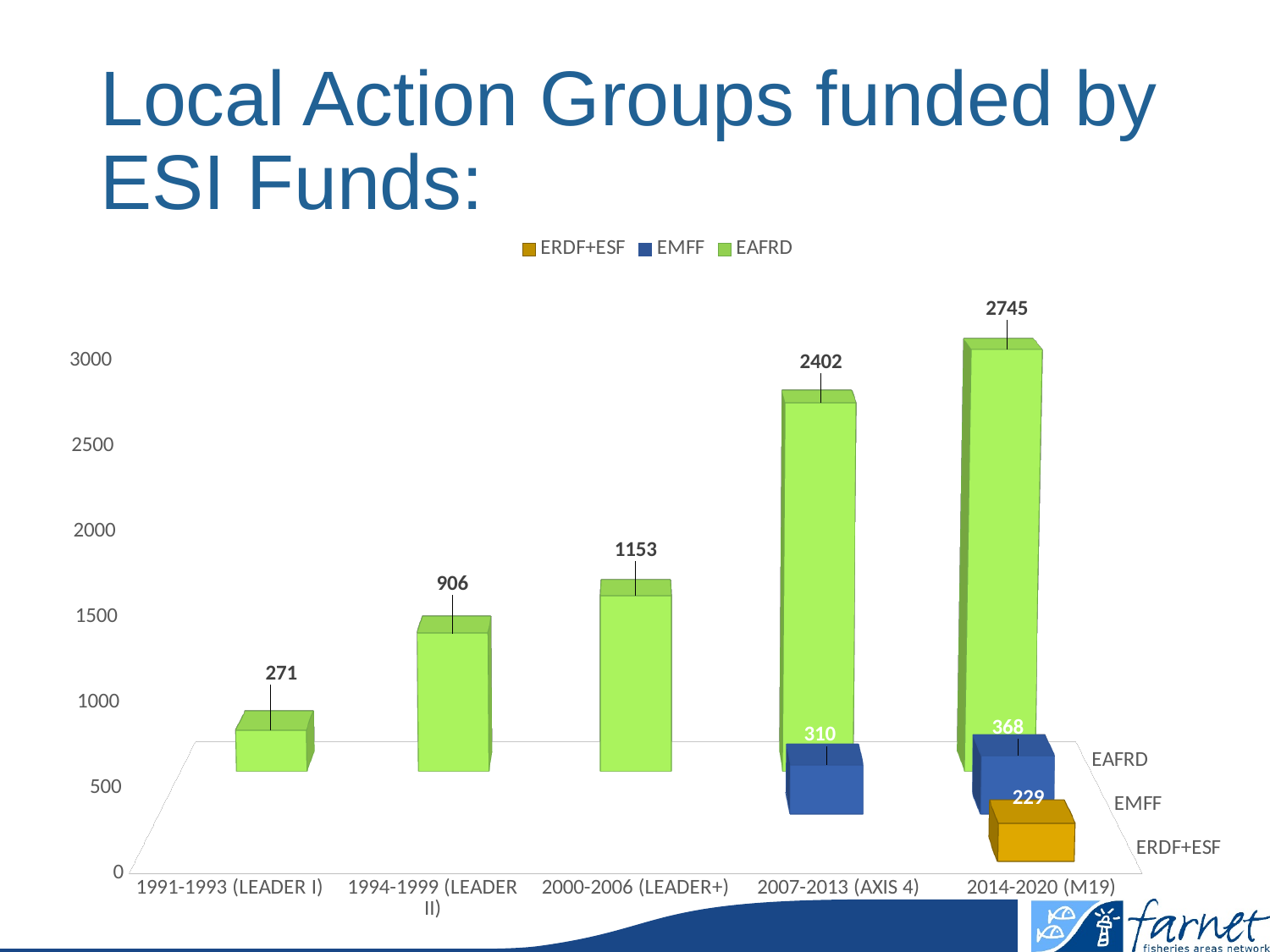
Which period has the lowest EAFRD value? 1991-1993 (LEADER I) What is the difference between the EAFRD values for 2014-2020 (M19) and 2007-2013 (AXIS 4)? 343 How many periods are shown on the x axis? 5 What is the EAFRD value for 1994-1999 (LEADER II)? 906 What is the EMFF value for 2007-2013 (AXIS 4)? 310 What kind of chart is shown on the slide? Bar chart Do the EAFRD values rise or fall from 1991-1993 (LEADER I) to 2014-2020 (M19)? Rise Which is larger: the EMFF value for 2014-2020 (M19) or the ERDF+ESF value for 2014-2020 (M19)? EMFF (368) How many series does the legend list? 3 What is the EAFRD value for 2014-2020 (M19)? 2745 Which period has the highest EAFRD value? 2014-2020 (M19) What is the ERDF+ESF value for 2014-2020 (M19)? 229